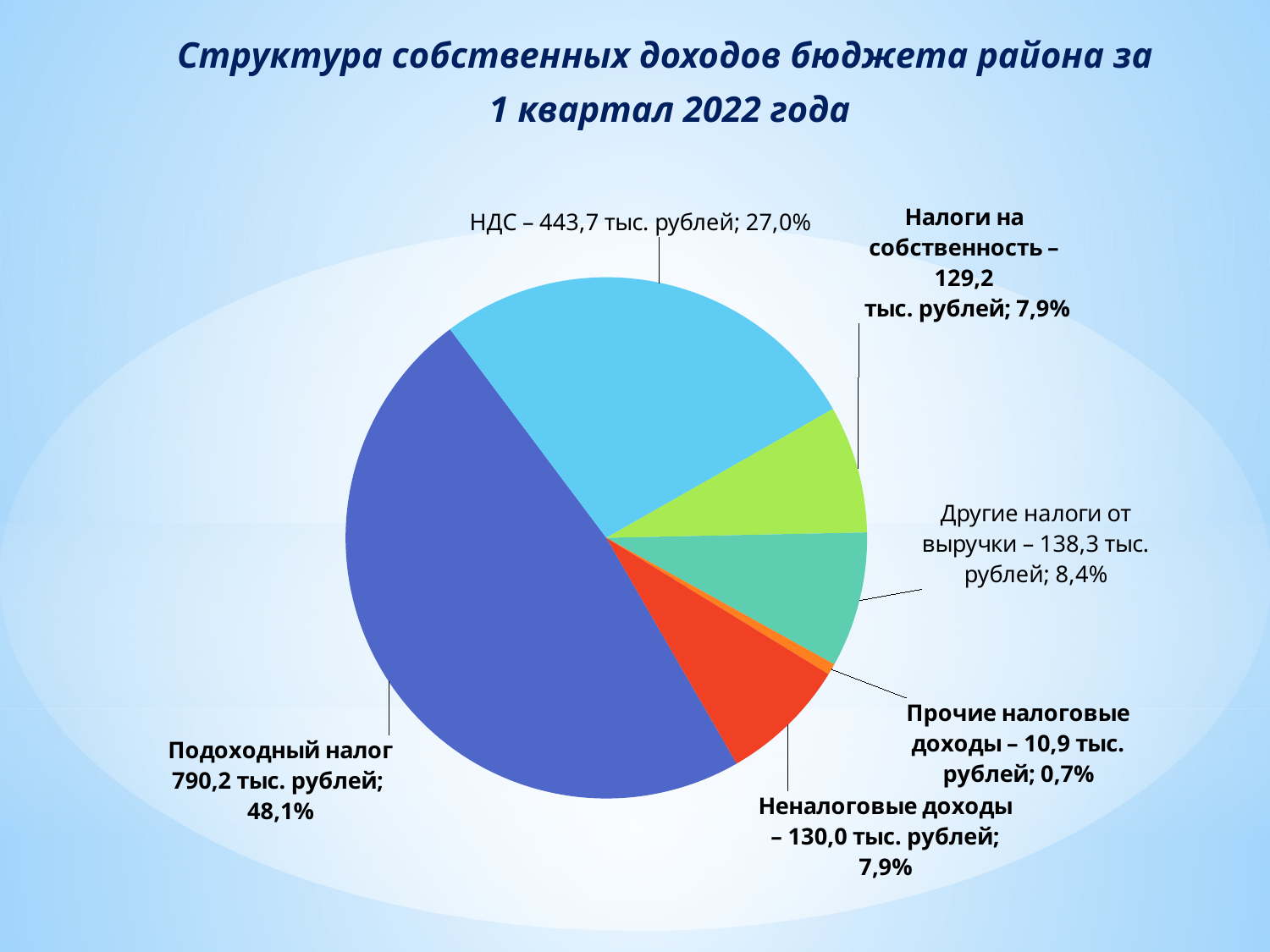
What is the difference in тыс. рублей between Подоходный налог and НДС? 346,5 тыс. рублей What is the title of the chart? Структура собственных доходов бюджета района за 1 квартал 2022 года Which is larger: Другие налоги от выручки or Налоги на собственность? Другие налоги от выручки Which category has the smallest slice? Прочие налоговые доходы What share of the pie does Неналоговые доходы represent? 7,9% How many slices does the pie chart have? 6 What type of chart is shown on the slide? Pie chart What share of the pie does НДС represent? 27,0% What is the value for Другие налоги от выручки? 138,3 тыс. рублей What is the value for Подоходный налог? 790,2 тыс. рублей What share of the pie does Прочие налоговые доходы represent? 0,7% Which category has the largest slice? Подоходный налог